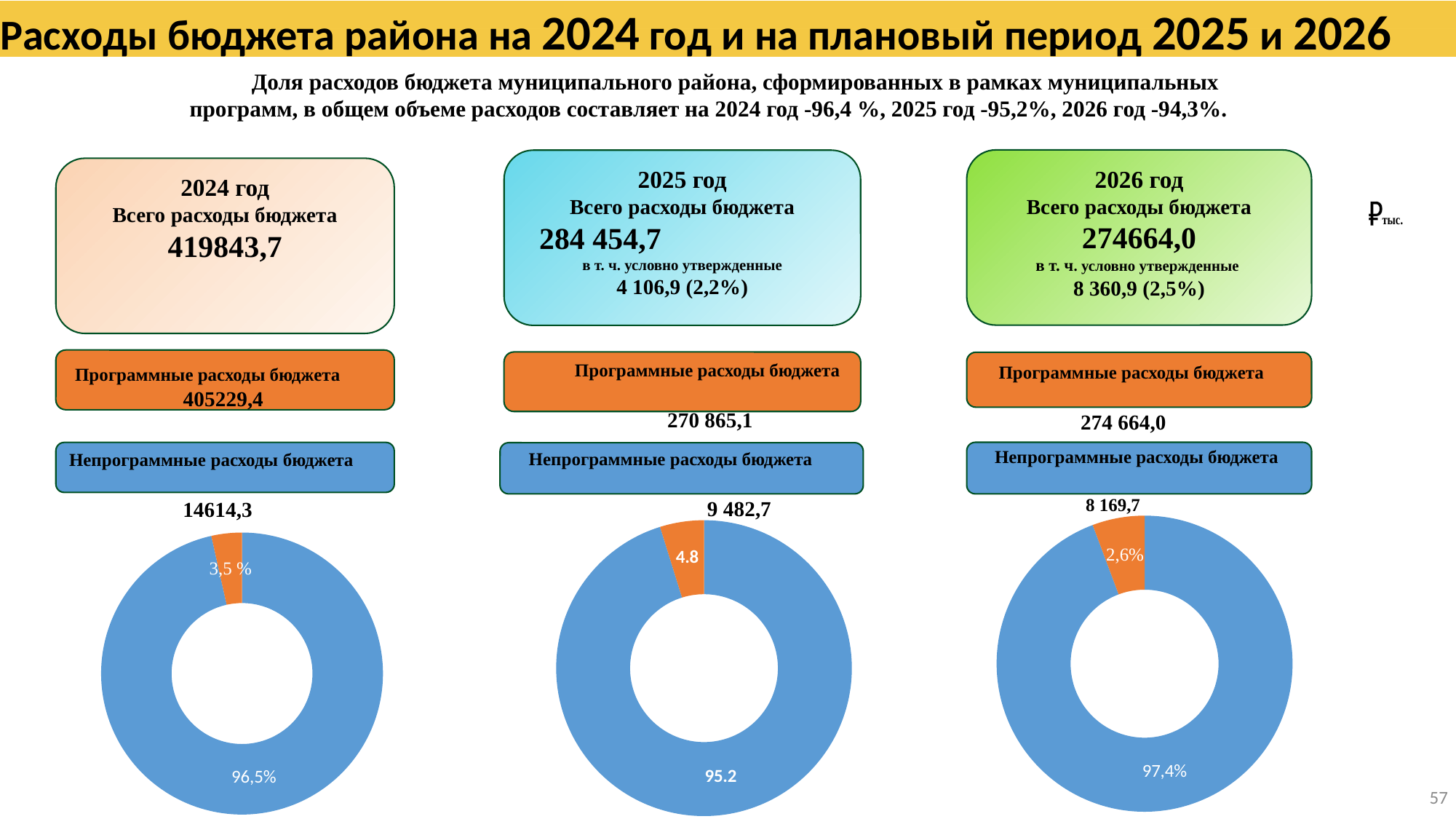
In the left donut chart (2024), what share is shown on the small orange slice? 3,5 % In the middle donut chart (2025), what value is shown on the blue slice? 95.2 In the right donut chart (2026), what share is shown on the orange slice? 2,6% In the left donut chart (2024), what share is shown on the large blue slice? 96,5% In the left donut chart (2024), which slice is larger, the blue one or the orange one? The blue one In the right donut chart (2026), what share is shown on the blue slice? 97,4% What kind of chart is shown under the 2024 column on the left? Donut (pie) chart What colour is the large slice in each of the three donut charts? Blue How many slices does the left donut chart (2024) have? 2 In the middle donut chart (2025), what value is shown on the orange slice? 4.8